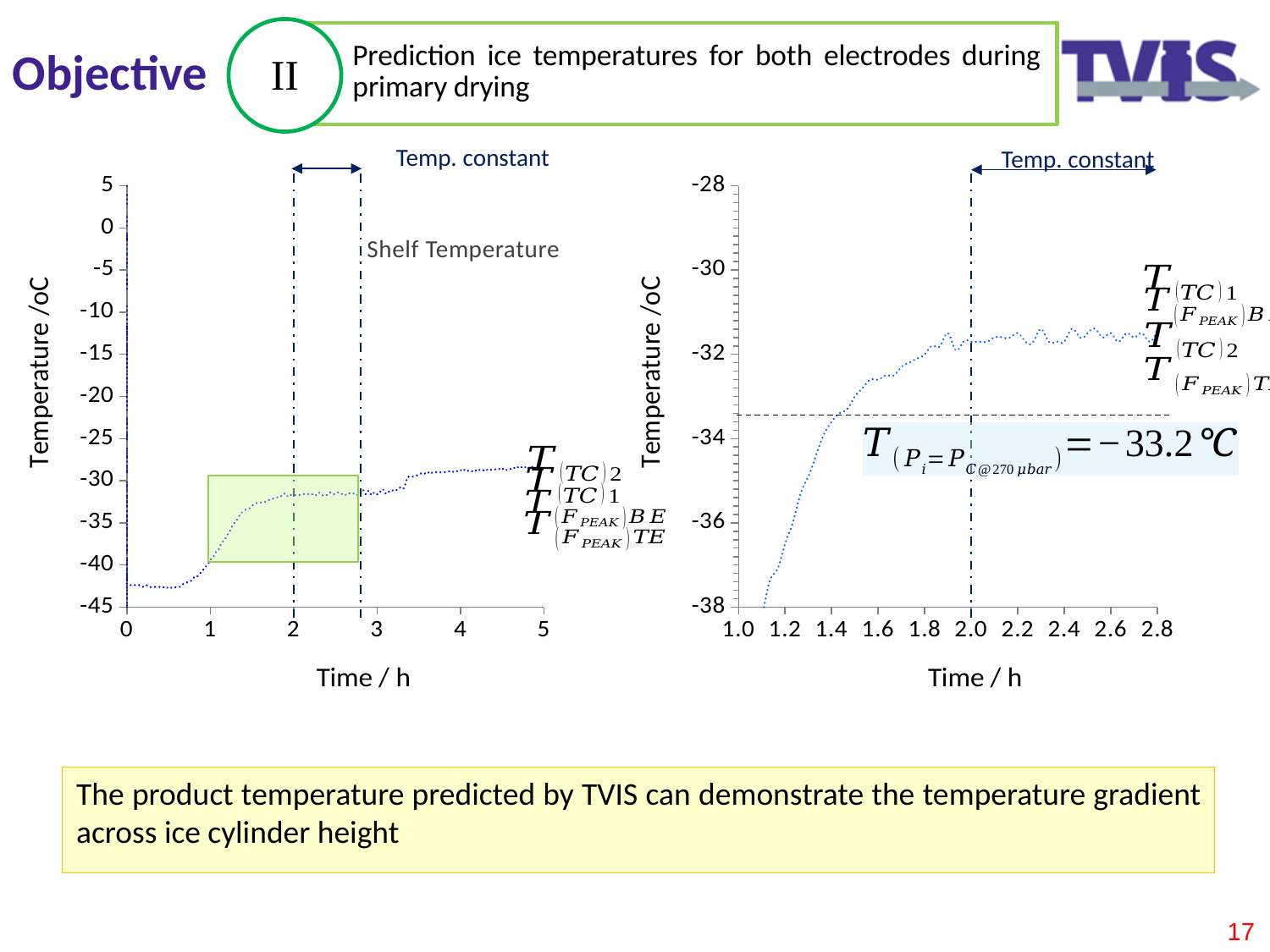
On the right chart, is the temperature at time 2.4 h greater or less than -34? greater On the left chart, is the temperature at time 0 h greater or less than -40? less What is the maximum time value shown on the x-axis of the left chart? 5 On the right chart, is the temperature at time 1.2 h greater or less than -36? less What is the x-axis label of the left chart? Time / h On the right chart, what temperature value is given in the annotation T(Pi=Pc@270 µbar)? -33.2 °C What is the y-axis label of the right chart? Temperature /oC On the left chart, does the temperature rise or fall between 0.5 h and 2 h? rise What kind of chart is the left chart on the slide? line chart On the right chart, does the temperature rise or fall between 1.0 h and 2.0 h? rise